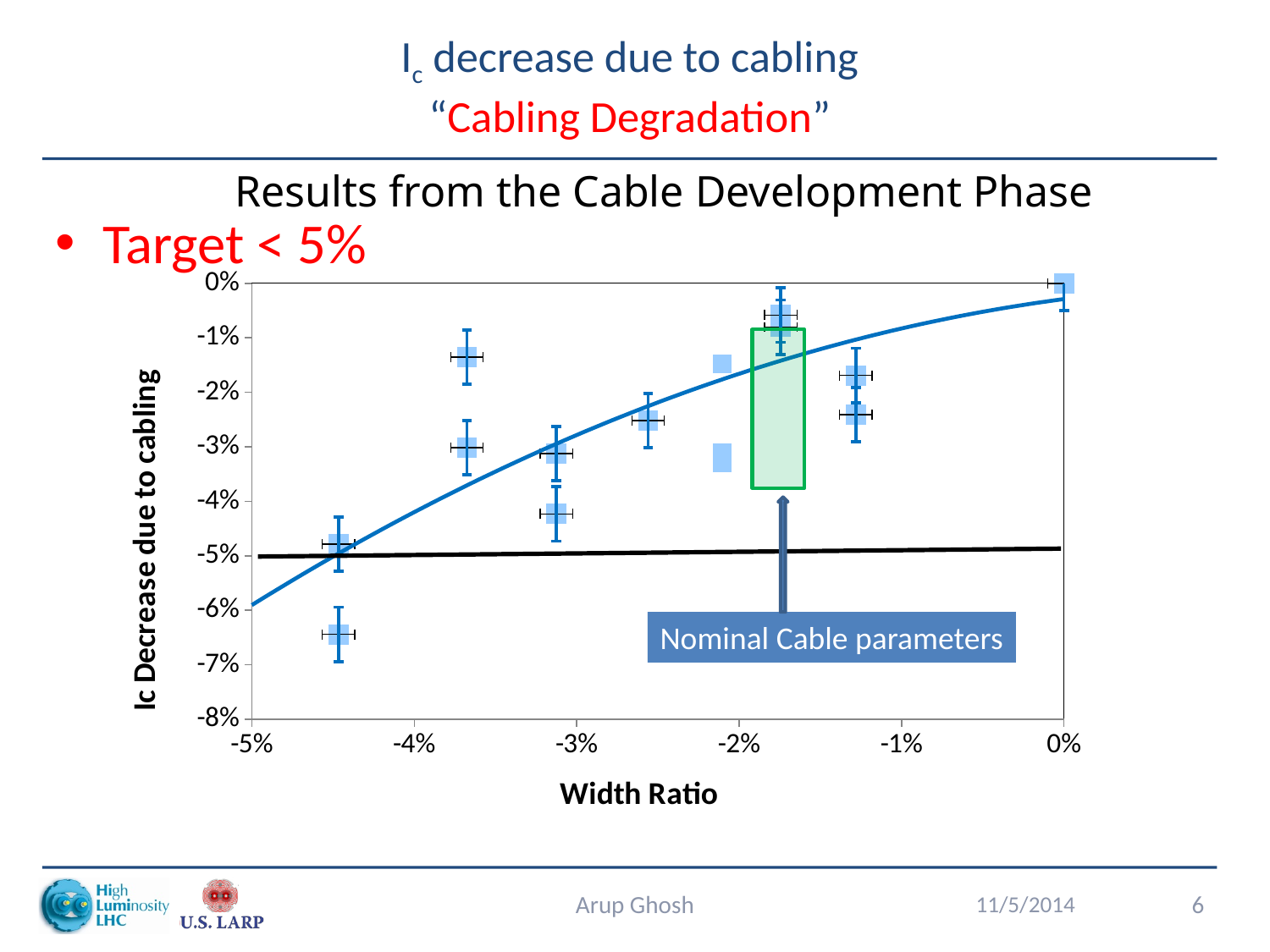
What kind of chart is shown on the slide? scatter chart What is the title of the vertical axis? Ic Decrease due to cabling Is the value of the highest data point near a width ratio of -3.7% greater or less than -2%? greater As the width ratio increases from -5% toward 0%, do the Ic decrease values generally rise or fall? rise What is the title of the horizontal axis? Width Ratio Is the horizontal black line on the chart greater or less than -4%? less Is the data point near a width ratio of -2.5% greater or less than -2%? less